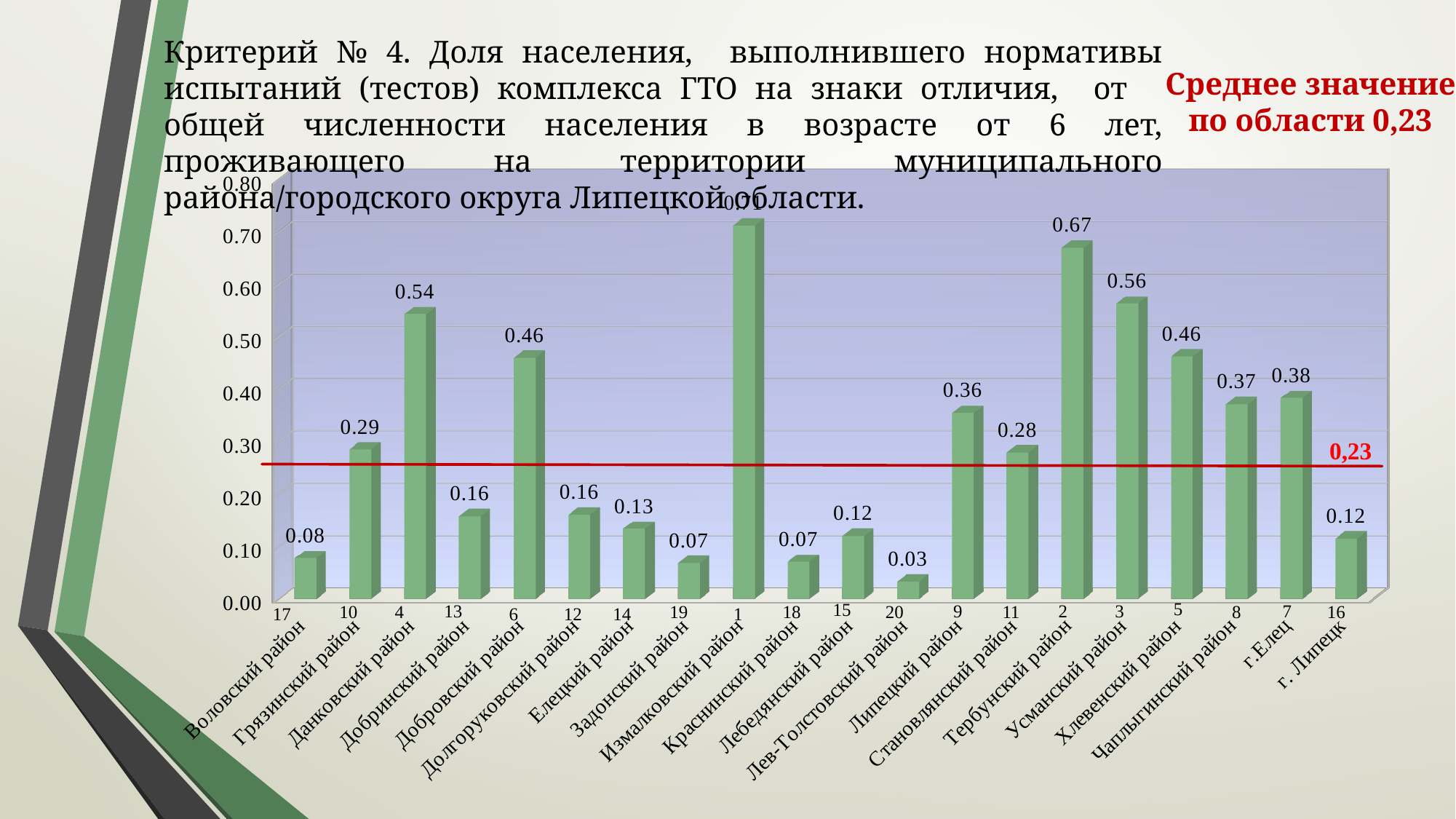
What is the value for Данковский район? 0.54 Is the value for Липецкий район greater or less than 0.30? greater What is the difference between the values for Тербунский район and Усманский район? 0.11 What is the value for Тербунский район? 0.67 What is the difference between the values for Данковский район and Грязинский район? 0.25 What value does the red horizontal line on the chart mark? 0,23 How many districts/cities are shown on the x axis of the chart? 20 Which has a larger value, г.Елец or Чаплыгинский район? г.Елец Which district has the lowest value on the chart? Лев-Толстовский район What kind of chart is shown on the slide? bar chart Which district has the highest value on the chart? Измалковский район What is the value for г. Липецк? 0.12